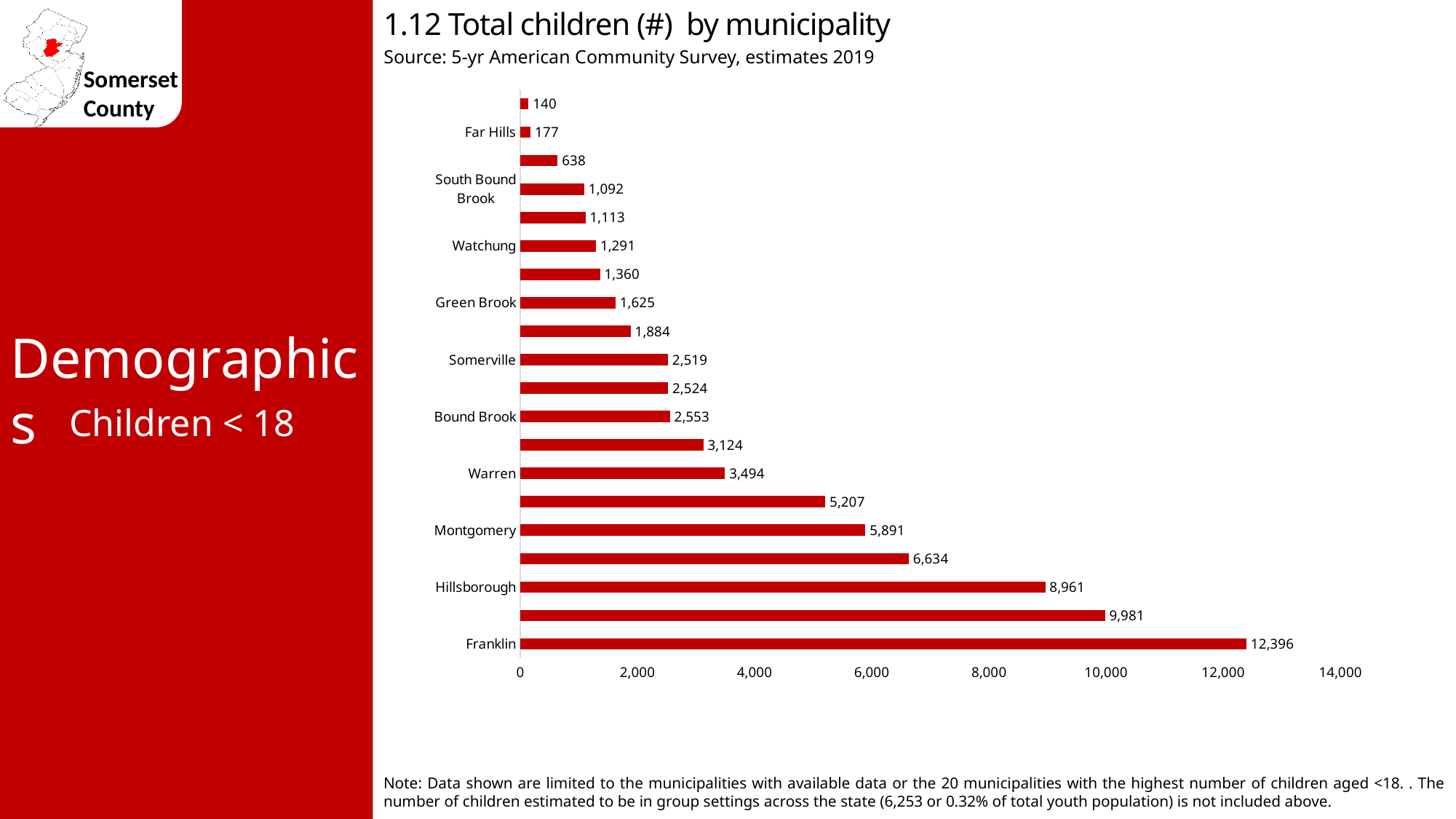
What is the value for Franklin? 12,396 What is the difference between the values for Franklin and Hillsborough? 3,435 Is the value for Warren greater or less than 4,000? less What is the value for Far Hills? 177 What is the difference between the values for Montgomery and Warren? 2,397 Which is larger, the value for Watchung or the value for Green Brook? Green Brook What kind of chart is shown on the slide? bar chart What is the value for Somerville? 2,519 Which municipality has the highest number of children? Franklin How many bars are shown on the chart? 20 What is the value for Hillsborough? 8,961 What is the smallest value shown on the chart? 140